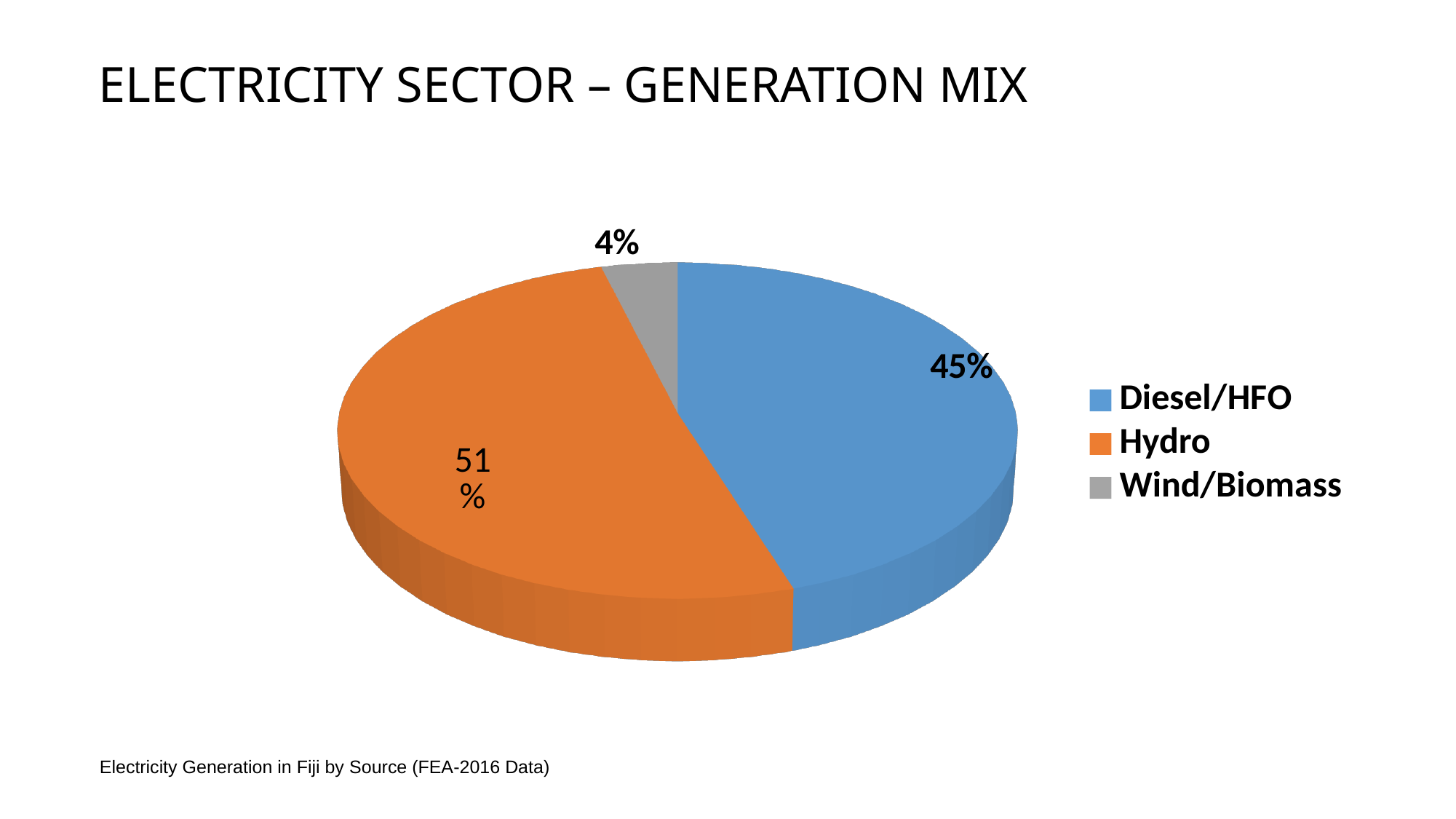
Which source has the largest share of the pie? Hydro What is the difference in percentage points between the Hydro and Diesel/HFO shares? 6 How many sources are shown in the pie chart? 3 What is the difference in percentage points between the Diesel/HFO and Wind/Biomass shares? 41 What share of the pie does Diesel/HFO have? 45% What share of the pie does Hydro have? 51% What is the caption below the chart? Electricity Generation in Fiji by Source (FEA-2016 Data) Which is larger, the share for Diesel/HFO or the share for Wind/Biomass? Diesel/HFO Which colour represents Hydro in the pie chart? Orange What kind of chart is shown on the slide? Pie chart What share of the pie does Wind/Biomass have? 4% Which source has the smallest share of the pie? Wind/Biomass